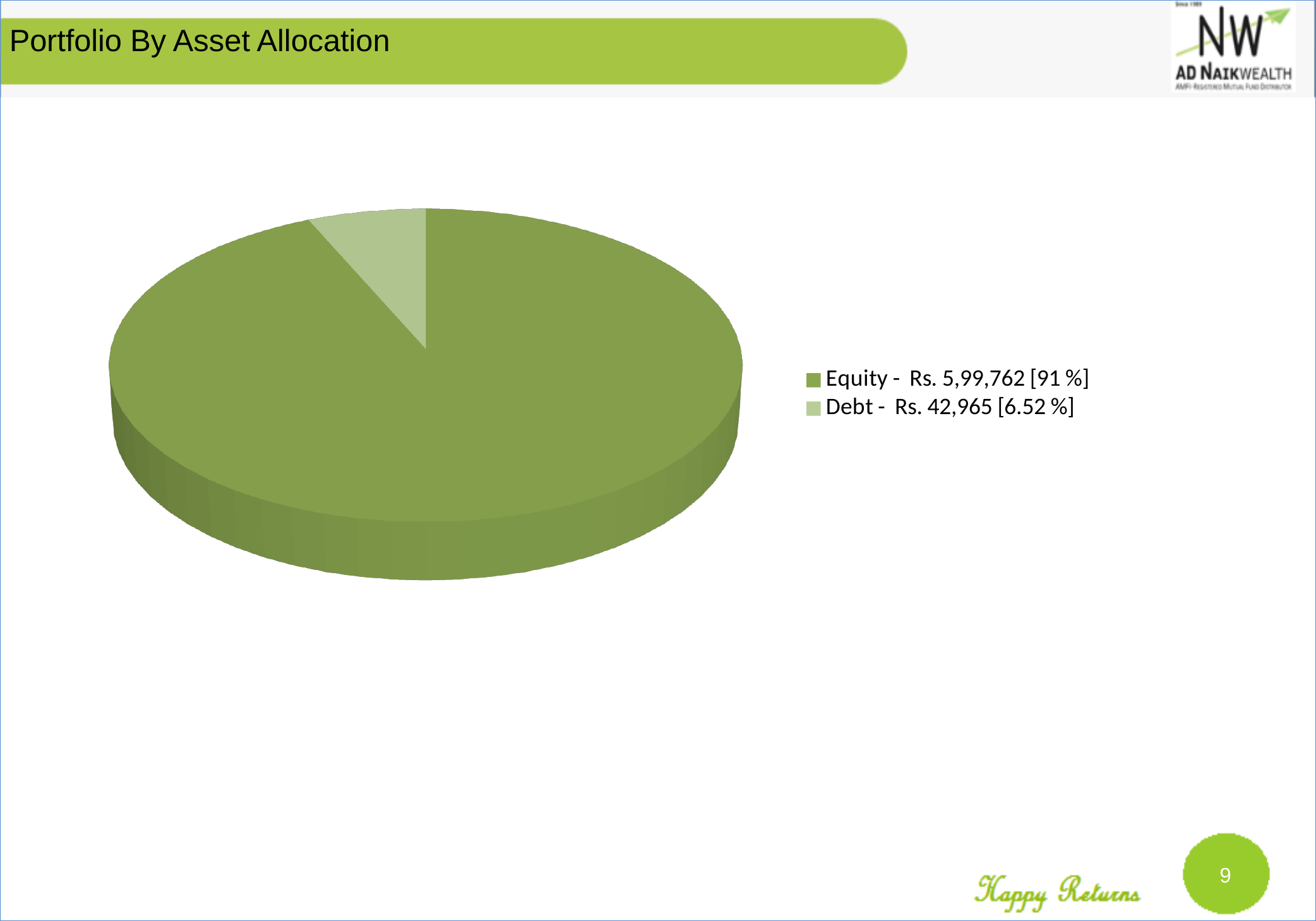
How many slices does the pie chart have? 2 What is the value for Equity? Rs. 5,99,762 Which asset class has the smallest slice of the pie? Debt How many entries does the legend list? 2 What is the value for Debt? Rs. 42,965 What kind of chart is shown on the slide? pie chart Which asset class has the largest slice of the pie? Equity What percentage share of the pie does Debt hold? 6.52 % What percentage share of the pie does Equity hold? 91 % What is the title of the slide containing the chart? Portfolio By Asset Allocation Which is larger, the value for Equity or the value for Debt? Equity What is the difference between the Equity value and the Debt value? Rs. 5,56,797